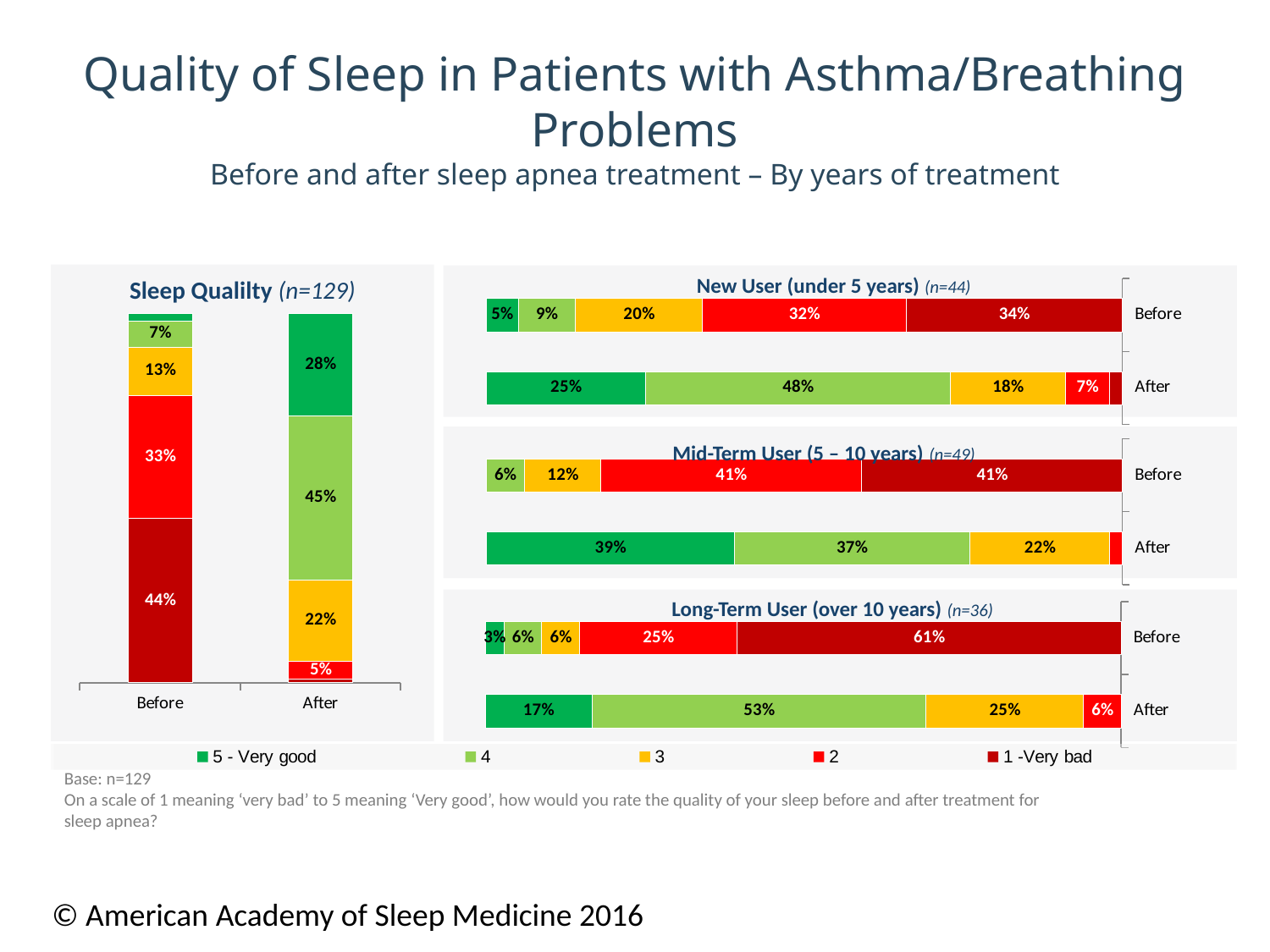
In the New User (under 5 years) chart, which is larger in the Before bar: the share rating 2 or the share rating '1 - Very bad'? 1 - Very bad In the New User (under 5 years) chart, what percentage gave a rating of 4 after treatment? 48% In the Long-Term User (over 10 years) chart, which rating has the largest share in the After bar? 4 In the Mid-Term User (5 – 10 years) chart, what percentage rated their sleep '5 - Very good' after treatment? 39% In the Long-Term User (over 10 years) chart, what percentage rated their sleep '1 - Very bad' before treatment? 61% What is the sample size (n) shown for the Mid-Term User (5 – 10 years) chart? n=49 In the Sleep Quality (n=129) chart, what percentage of patients rated their sleep '1 - Very bad' before treatment? 44% In the New User (under 5 years) chart, what percentage gave a rating of 2 before treatment? 32% How many series does the shared legend at the bottom of the slide list? 5 In the Long-Term User (over 10 years) chart, by how many percentage points does the share rating 3 differ between Before (6%) and After (25%)? 19 percentage points In the Sleep Quality (n=129) chart, what percentage of patients gave a rating of 4 after treatment? 45% What kind of chart is the Sleep Quality (n=129) chart? Stacked bar chart